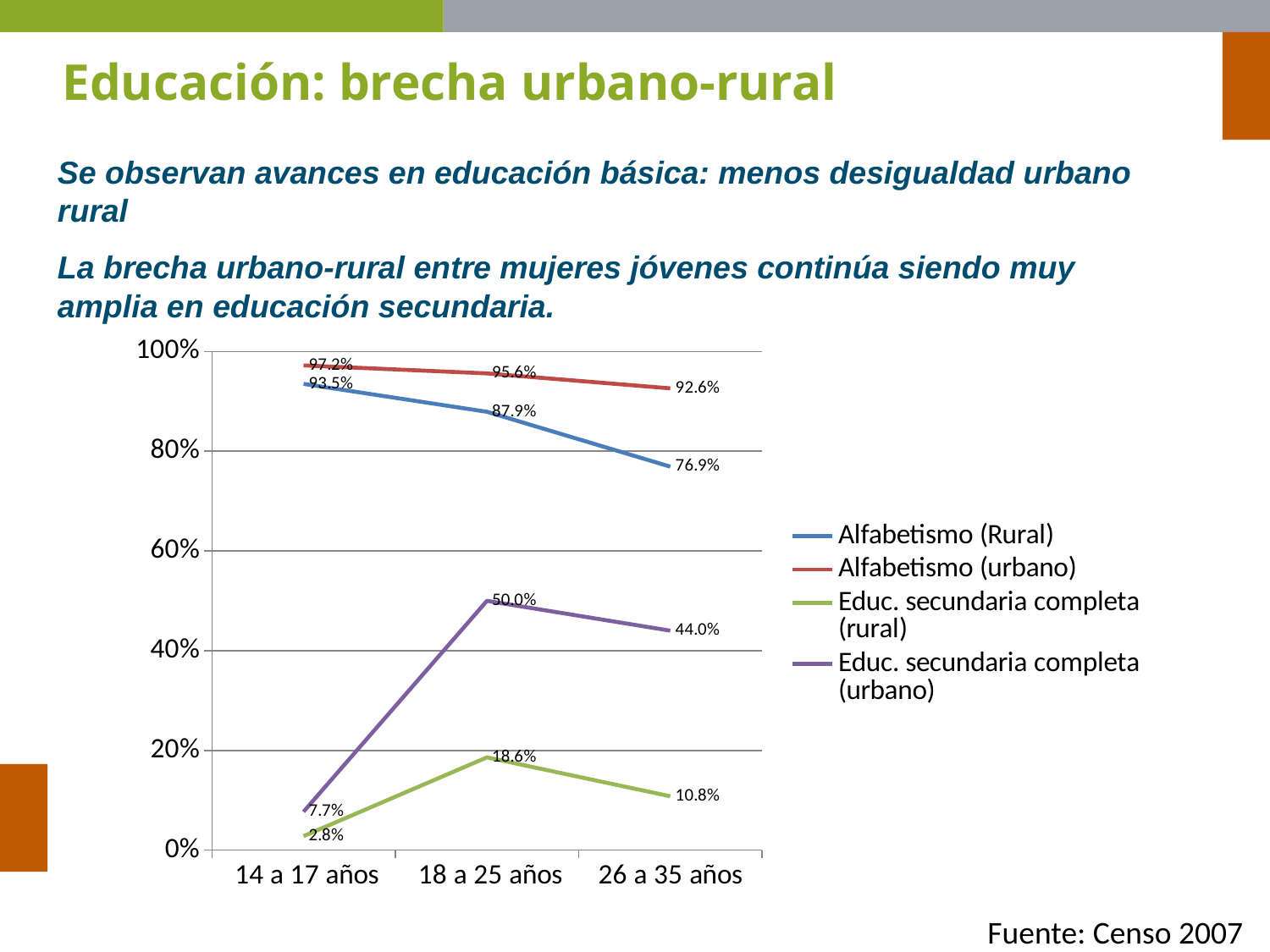
What is the difference between Alfabetismo (urbano) and Alfabetismo (Rural) for 26 a 35 años? 15.7% What is the value of Educ. secundaria completa (urbano) for 18 a 25 años? 50.0% For which age group is Alfabetismo (Rural) lowest? 26 a 35 años What is the value of Alfabetismo (Rural) for 26 a 35 años? 76.9% Does the Alfabetismo (Rural) line rise or fall from 14 a 17 años to 26 a 35 años? fall How many series does the legend list? 4 Which is larger for 18 a 25 años: Educ. secundaria completa (urbano) or Educ. secundaria completa (rural)? Educ. secundaria completa (urbano) What is the value of Educ. secundaria completa (rural) for 14 a 17 años? 2.8% What type of chart is shown on the slide? line chart How many age-group categories are shown on the x axis? 3 What is the value of Alfabetismo (urbano) for 26 a 35 años? 92.6% For which age group is Educ. secundaria completa (rural) highest? 18 a 25 años